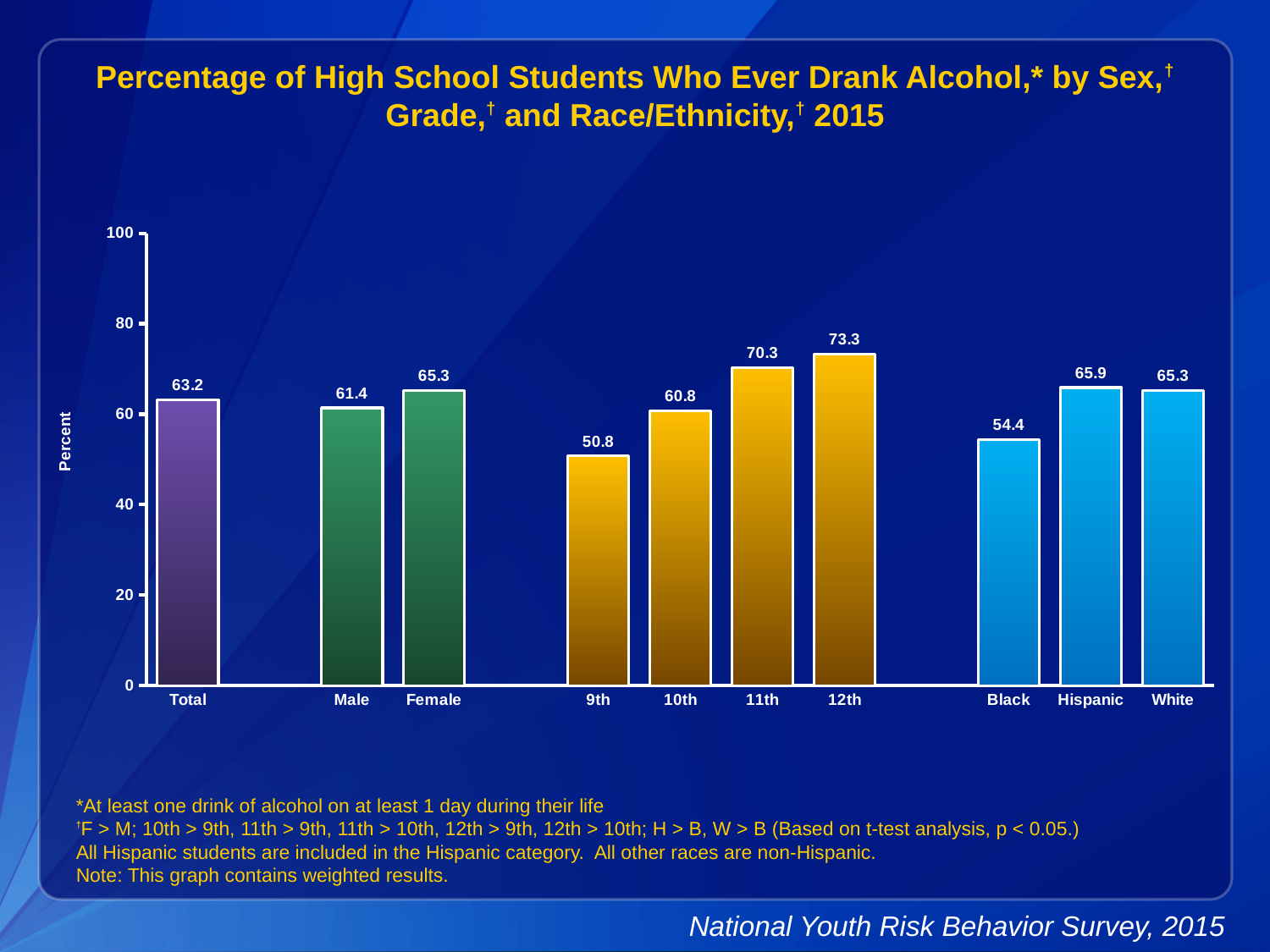
Do the values rise or fall from 9th grade to 12th grade? rise What kind of chart is this? bar chart Which category has the highest value? 12th What is the value for Total? 63.2 Which category has the lowest value? 9th Is the value for 11th grade greater or less than 60? greater Which is larger, the value for Black students or the value for White students? White What is the difference between the Female and Male values? 3.9 What is the value for Hispanic students? 65.9 How many categories are shown on the x axis? 10 What is the difference between the 12th grade and 9th grade values? 22.5 What is the value for 9th grade students? 50.8